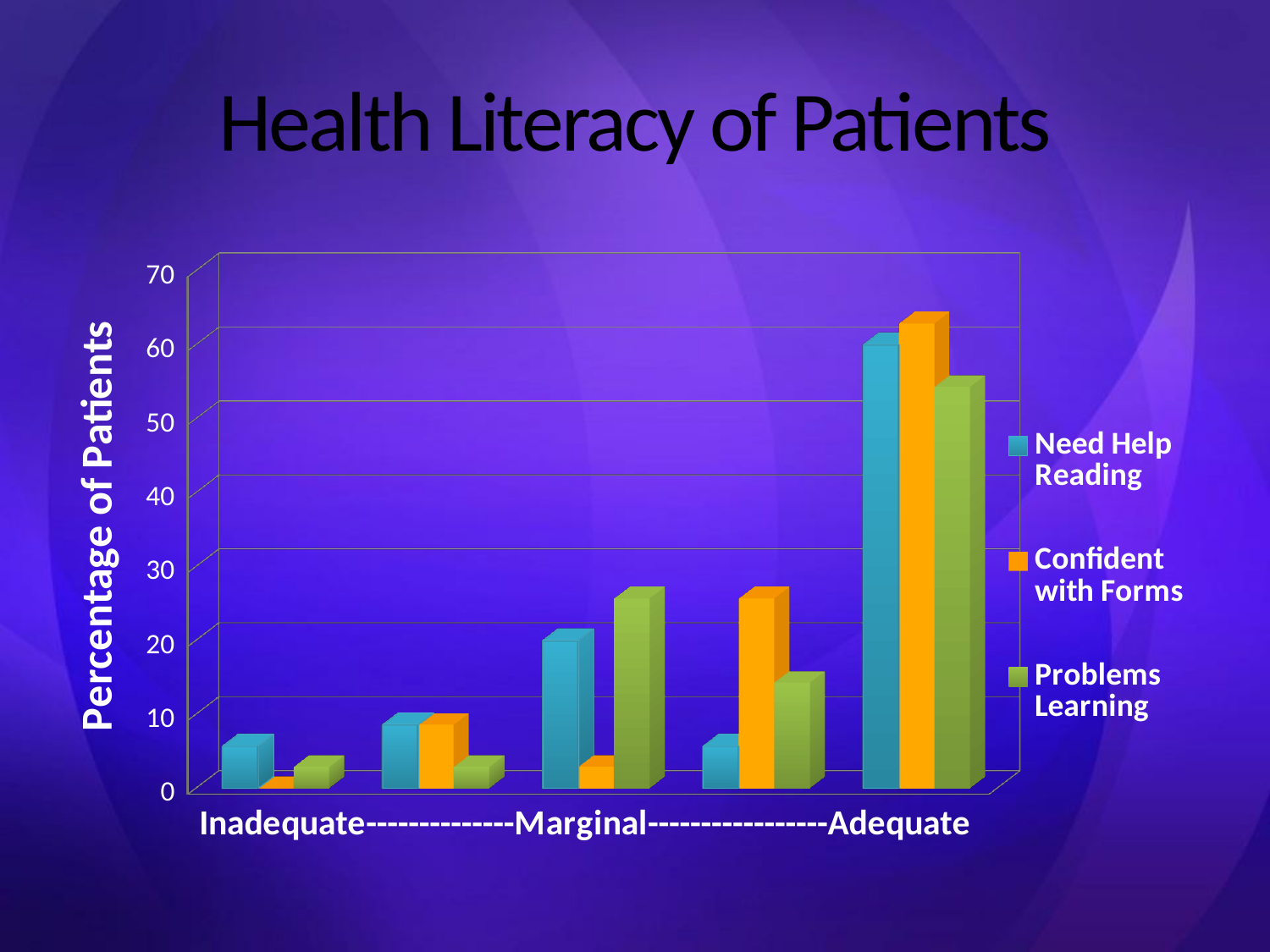
How many series does the legend list? 3 How many groups of bars are plotted along the x axis? 5 In the fourth group of bars from the left, which series has the highest value? Confident with Forms In the rightmost group of bars, which series has the lowest value? Problems Learning Which series is shown in orange in the legend? Confident with Forms In the leftmost group of bars, is the value for Need Help Reading greater or less than 10? less In the middle group of bars, is the value for Problems Learning greater or less than 20? greater In the rightmost group of bars, which is larger: Need Help Reading or Problems Learning? Need Help Reading In the rightmost group of bars, is the value for Need Help Reading greater or less than 50? greater In the middle group of bars, which series has the highest value? Problems Learning What kind of chart is shown on the slide? bar chart What is the title of the y axis? Percentage of Patients